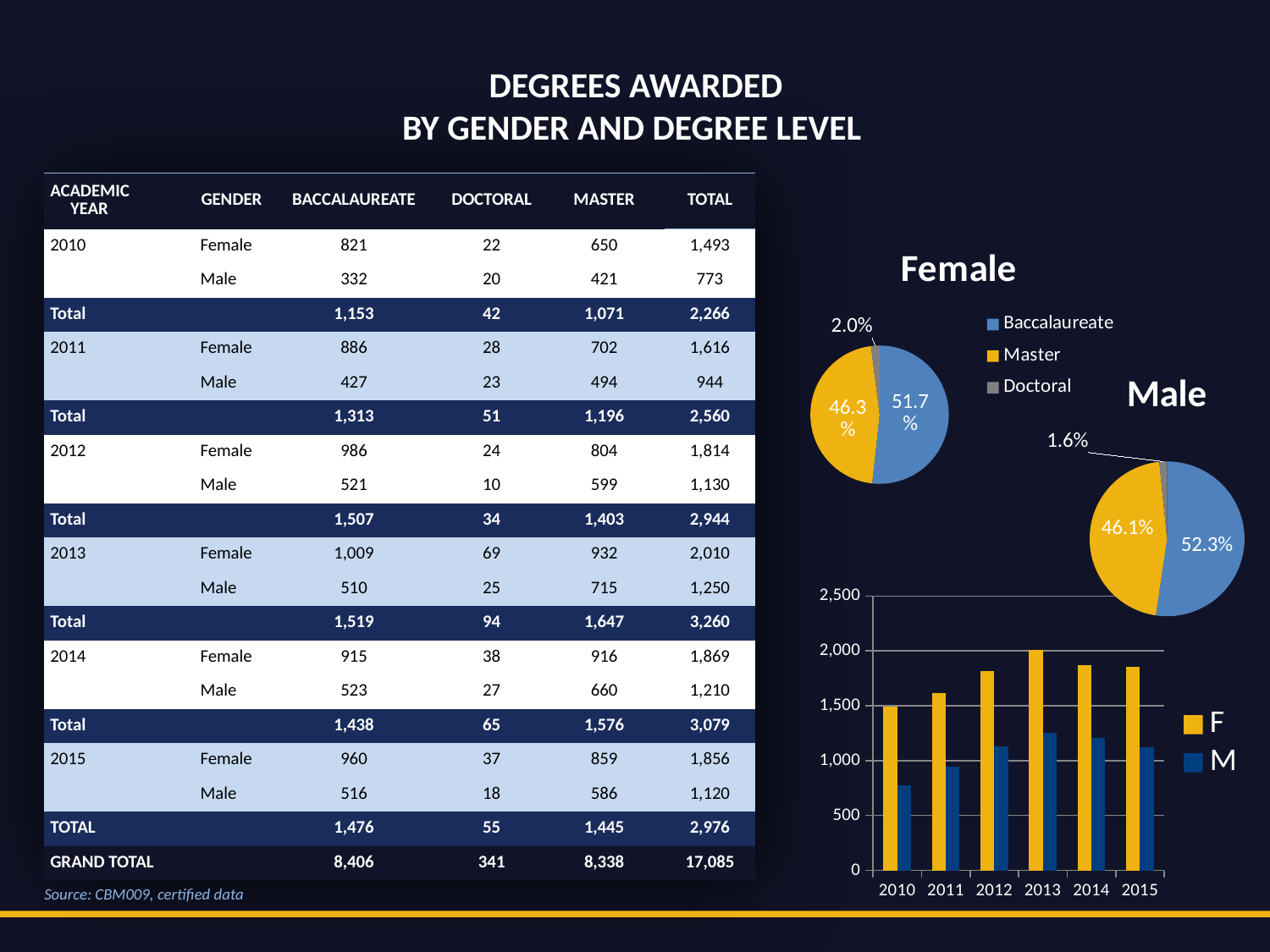
In the Male pie chart, which degree level has the smallest slice? Doctoral In the Female pie chart, what share of degrees is Doctoral? 2.0% In the Female pie chart, what share of degrees is Baccalaureate? 51.7% In the bar chart at the bottom right, is the F value for 2012 greater or less than 1,500? greater What kind of chart is the chart at the bottom right showing F and M by year? Bar chart In the Male pie chart, what share of degrees is Doctoral? 1.6% In the bar chart at the bottom right, how many years are shown on the x axis? 6 In the bar chart at the bottom right, which year has the tallest F bar? 2013 How many series does the legend of the pie charts list? 3 In the bar chart at the bottom right, is the M value for 2010 greater or less than 1,000? less